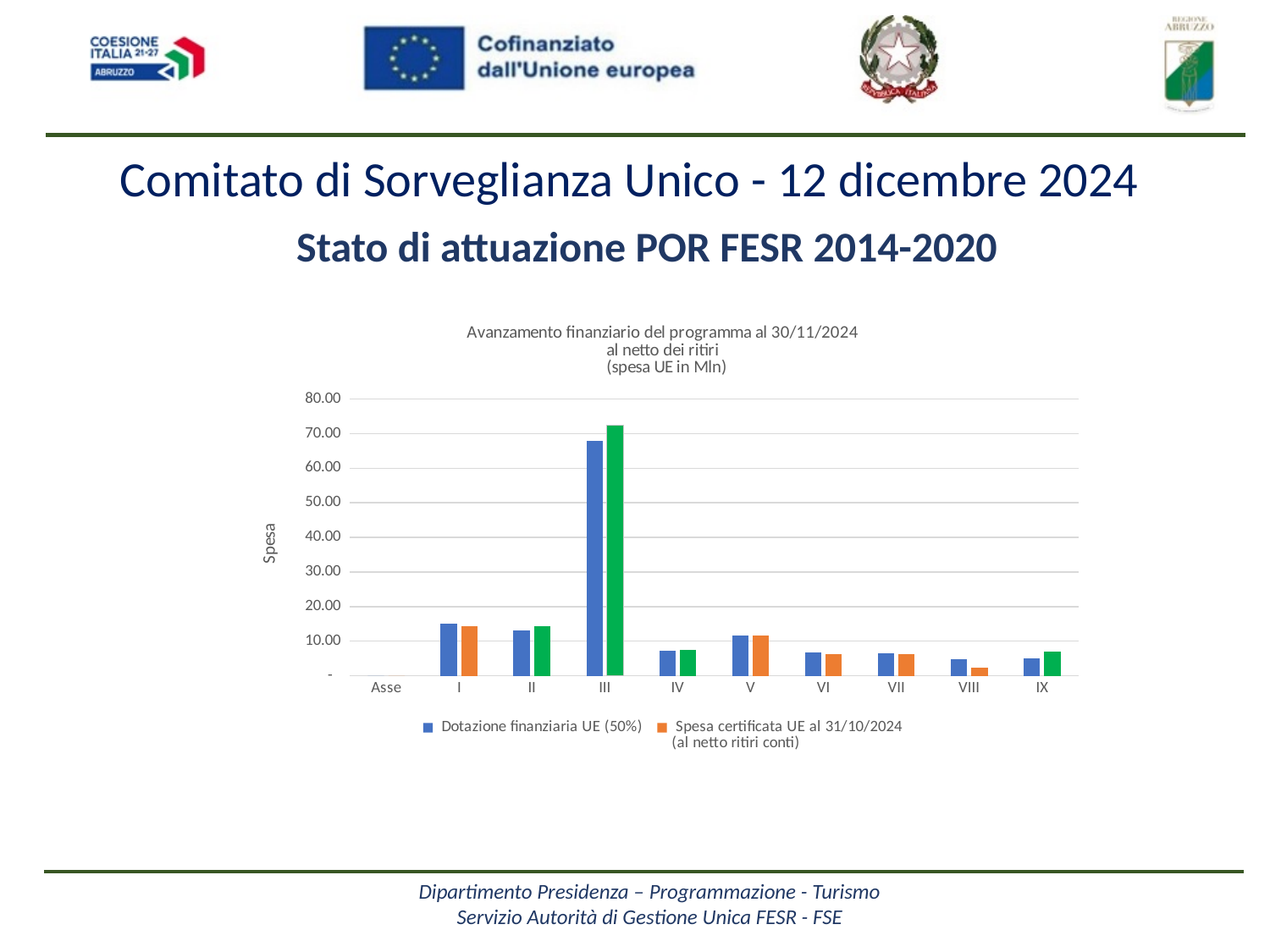
What is the title of the chart? Avanzamento finanziario del programma al 30/11/2024 al netto dei ritiri (spesa UE in Mln) How many categories are shown on the x axis of the chart? 10 Is the value of Dotazione finanziaria UE (50%) for Asse III greater or less than 60.00? greater Which is larger, the Dotazione finanziaria UE (50%) for Asse III or for Asse I? Asse III Is the value of Dotazione finanziaria UE (50%) for Asse I greater or less than 10.00? greater Is the value of Spesa certificata UE al 31/10/2024 for Asse VIII greater or less than 10.00? less Which is larger, the Dotazione finanziaria UE (50%) for Asse I or for Asse IV? Asse I What is the label of the y axis of the chart? Spesa Which category has the highest value for Dotazione finanziaria UE (50%)? III What kind of chart is shown on the slide? bar chart How many series does the chart legend list? 2